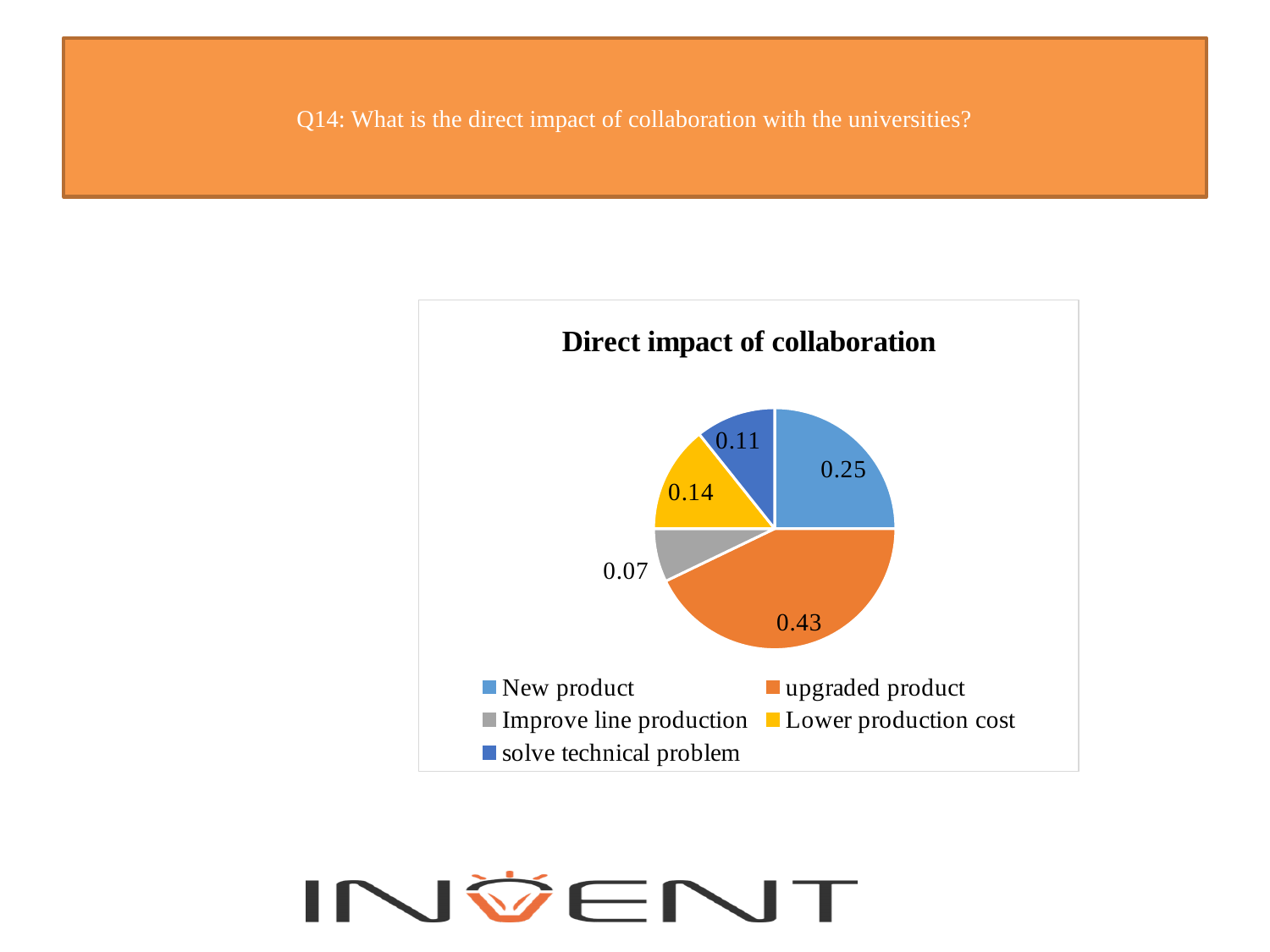
Which category has the largest slice? upgraded product Which is larger, the value for Lower production cost or the value for solve technical problem? Lower production cost What is the value for Lower production cost? 0.14 What is the value for upgraded product? 0.43 What kind of chart is shown on the slide? pie chart How many categories does the legend list? 5 What is the title of the chart? Direct impact of collaboration What is the value for Improve line production? 0.07 What is the value for New product? 0.25 Which category has the smallest slice? Improve line production What is the difference between the values for upgraded product and New product? 0.18 What is the value for solve technical problem? 0.11